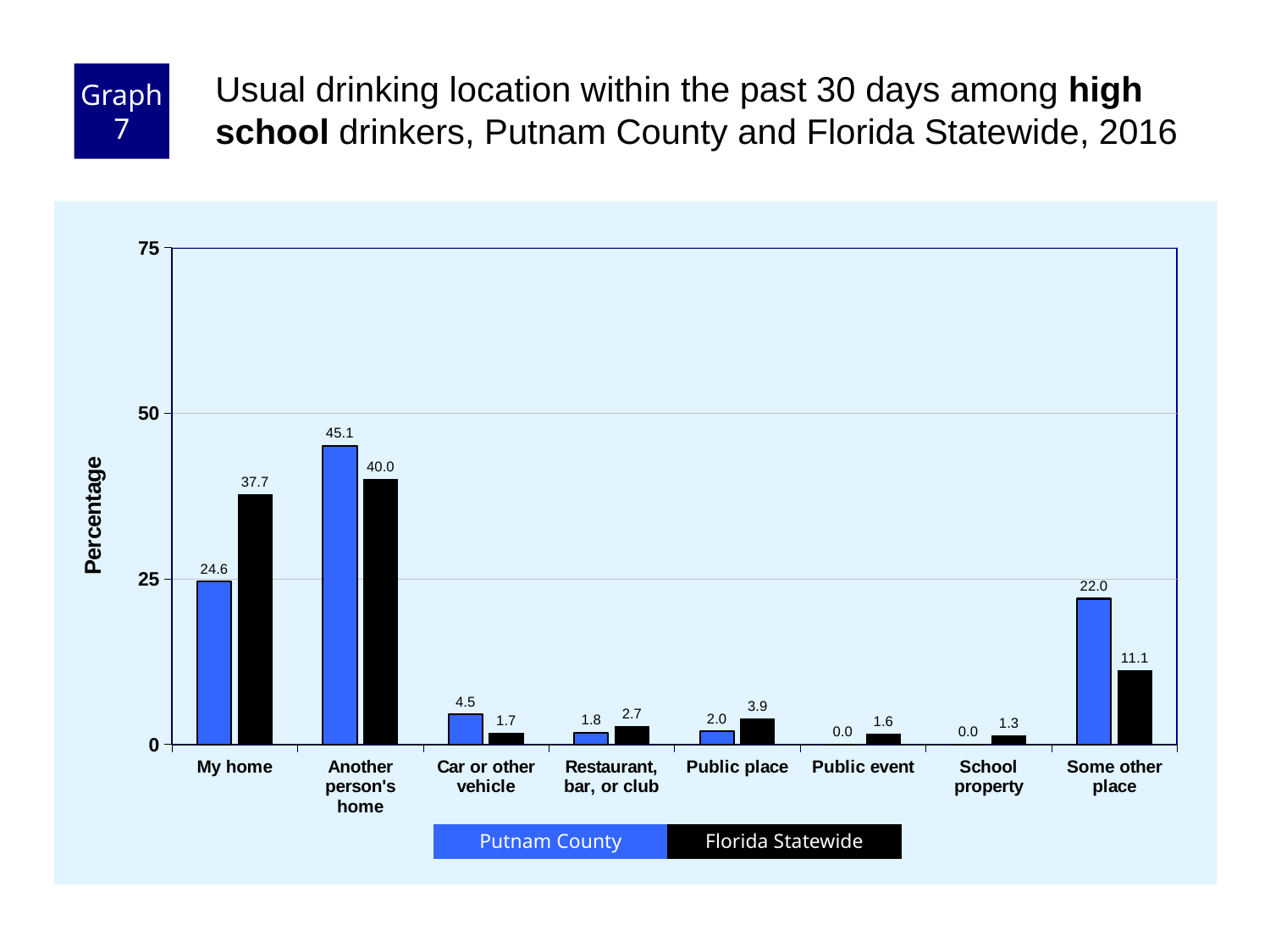
What is the label of the y axis? Percentage Is the Putnam County value for "Some other place" greater or less than 25? less How many categories are shown on the x axis? 8 How many series does the legend list? 2 Which category has the lowest Florida Statewide value? School property What kind of chart is shown on the slide? Bar chart What is the difference between the Putnam County and Florida Statewide values for "My home"? 13.1 What is the Florida Statewide value for "Some other place"? 11.1 What is the Putnam County value for "Another person's home"? 45.1 What is the Florida Statewide value for "My home"? 37.7 Which is larger for "Public place": Putnam County or Florida Statewide? Florida Statewide Which category has the highest Putnam County value? Another person's home